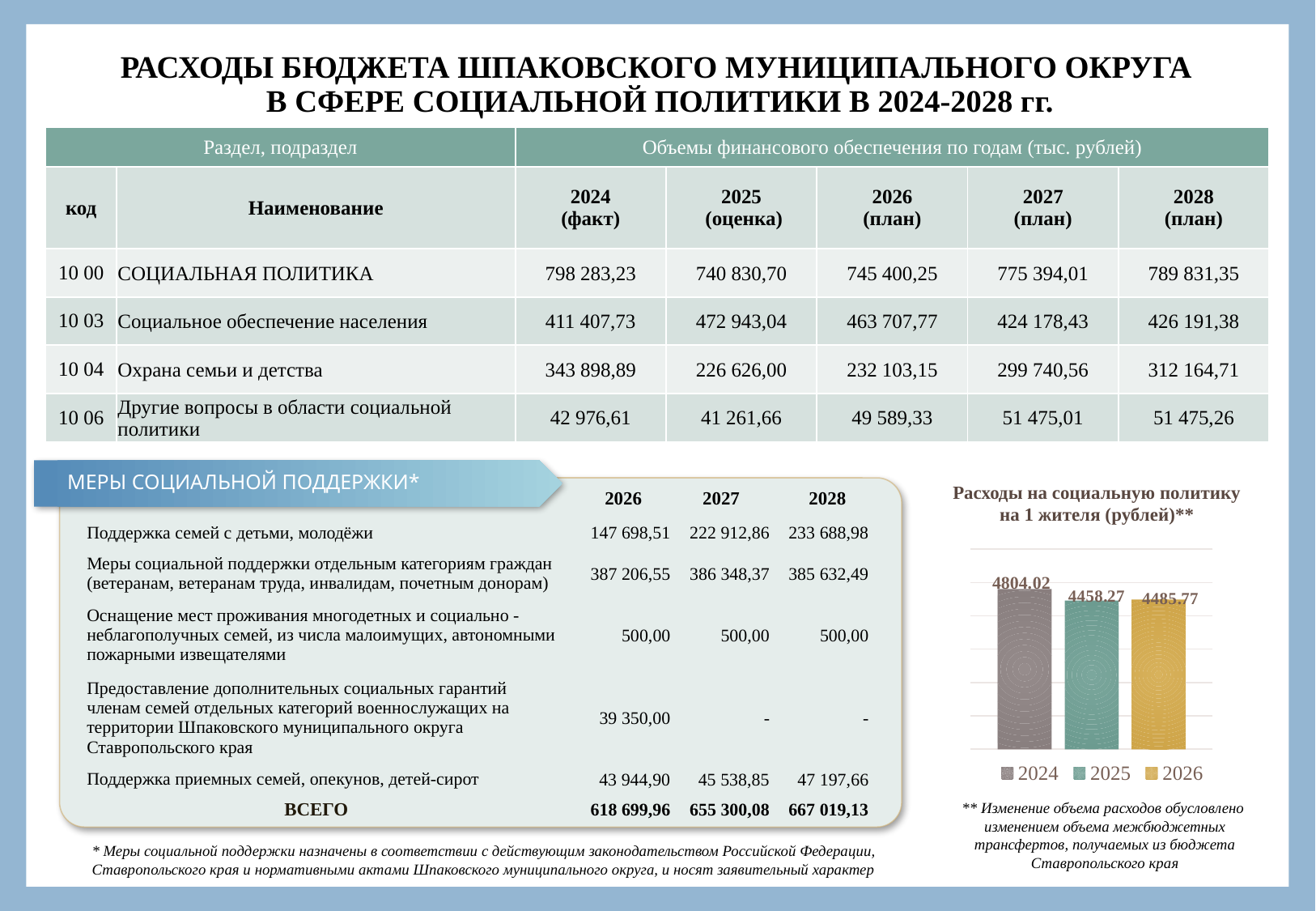
What is the value for 2026 in the chart "Расходы на социальную политику на 1 жителя (рублей)"? 4485.77 In the chart "Расходы на социальную политику на 1 жителя (рублей)", which year has the highest value? 2024 In the chart "Расходы на социальную политику на 1 жителя (рублей)", what is the difference between the 2024 and 2025 values? 345.75 What is the value for 2025 in the chart "Расходы на социальную политику на 1 жителя (рублей)"? 4458.27 What is the value for 2024 in the chart "Расходы на социальную политику на 1 жителя (рублей)"? 4804.02 In the chart "Расходы на социальную политику на 1 жителя (рублей)", does the value rise or fall from 2024 to 2025? fall In the chart "Расходы на социальную политику на 1 жителя (рублей)", which is larger: the value for 2025 or for 2026? 2026 How many bars are plotted in the chart "Расходы на социальную политику на 1 жителя (рублей)"? 3 In the chart "Расходы на социальную политику на 1 жителя (рублей)", what is the difference between the 2026 and 2025 values? 27.50 What kind of chart is "Расходы на социальную политику на 1 жителя (рублей)"? bar chart In the chart "Расходы на социальную политику на 1 жителя (рублей)", which year has the lowest value? 2025 How many entries does the legend of the chart "Расходы на социальную политику на 1 жителя (рублей)" list? 3